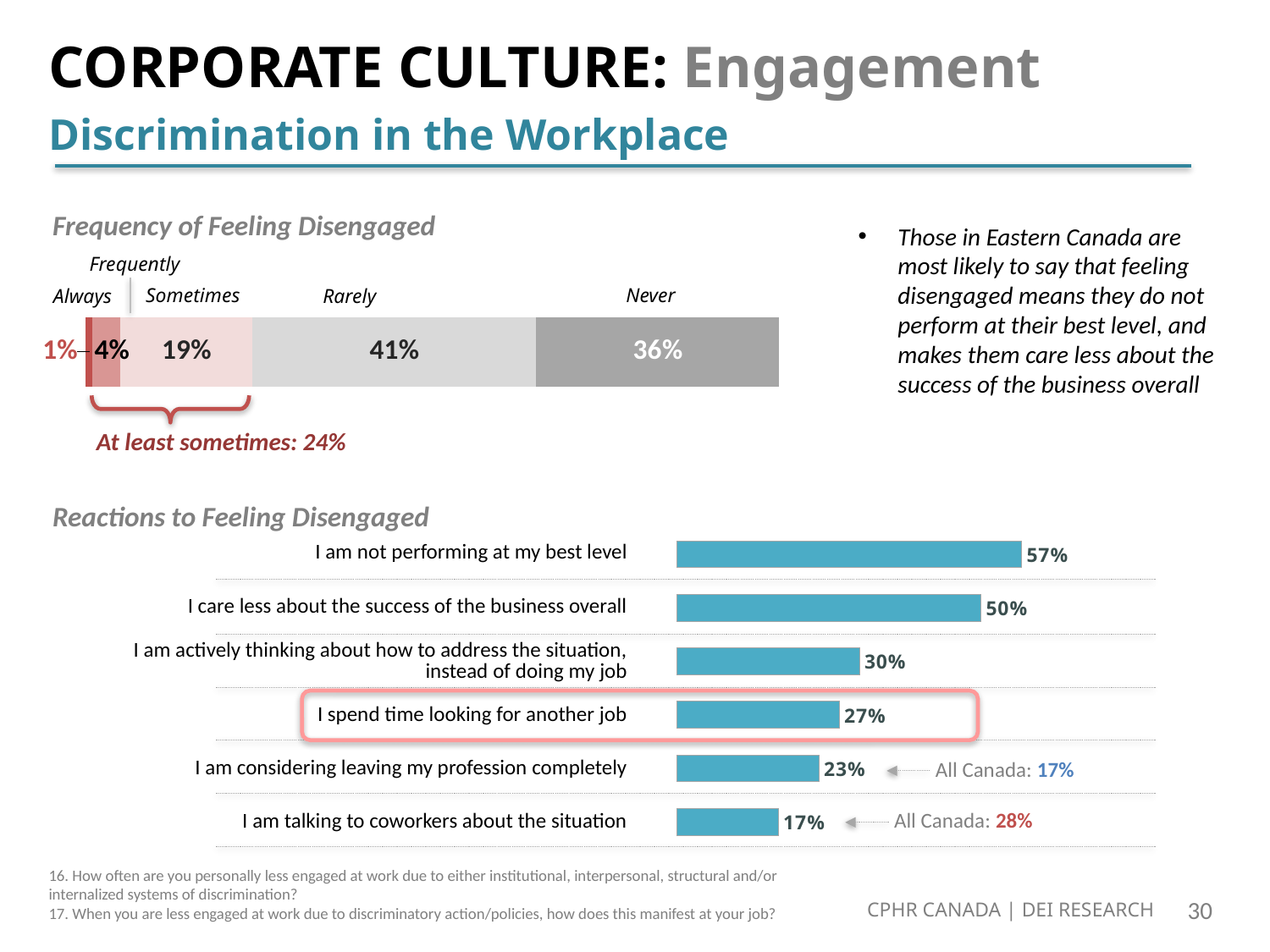
In the 'Frequency of Feeling Disengaged' chart, which response category has the highest percentage? Rarely In the 'Frequency of Feeling Disengaged' chart, what percentage of respondents say they never feel disengaged? 36% What kind of chart is 'Reactions to Feeling Disengaged'? Bar chart In the 'Frequency of Feeling Disengaged' chart, what percentage say they always feel disengaged? 1% In the 'Frequency of Feeling Disengaged' chart, what percentage say they rarely feel disengaged? 41% In the 'Reactions to Feeling Disengaged' chart, which reaction has the lowest percentage? I am talking to coworkers about the situation In the 'Reactions to Feeling Disengaged' chart, what percentage say 'I spend time looking for another job'? 27% In the 'Reactions to Feeling Disengaged' chart, what is the All Canada value shown for 'I am considering leaving my profession completely'? 17% In the 'Reactions to Feeling Disengaged' chart, what percentage say 'I am not performing at my best level'? 57% In the 'Frequency of Feeling Disengaged' chart, how many response categories are shown in the stacked bar? 5 In the 'Reactions to Feeling Disengaged' chart, what is the difference between 'I am not performing at my best level' and 'I care less about the success of the business overall'? 7% In the 'Frequency of Feeling Disengaged' chart, what is the combined percentage for 'At least sometimes'? 24%